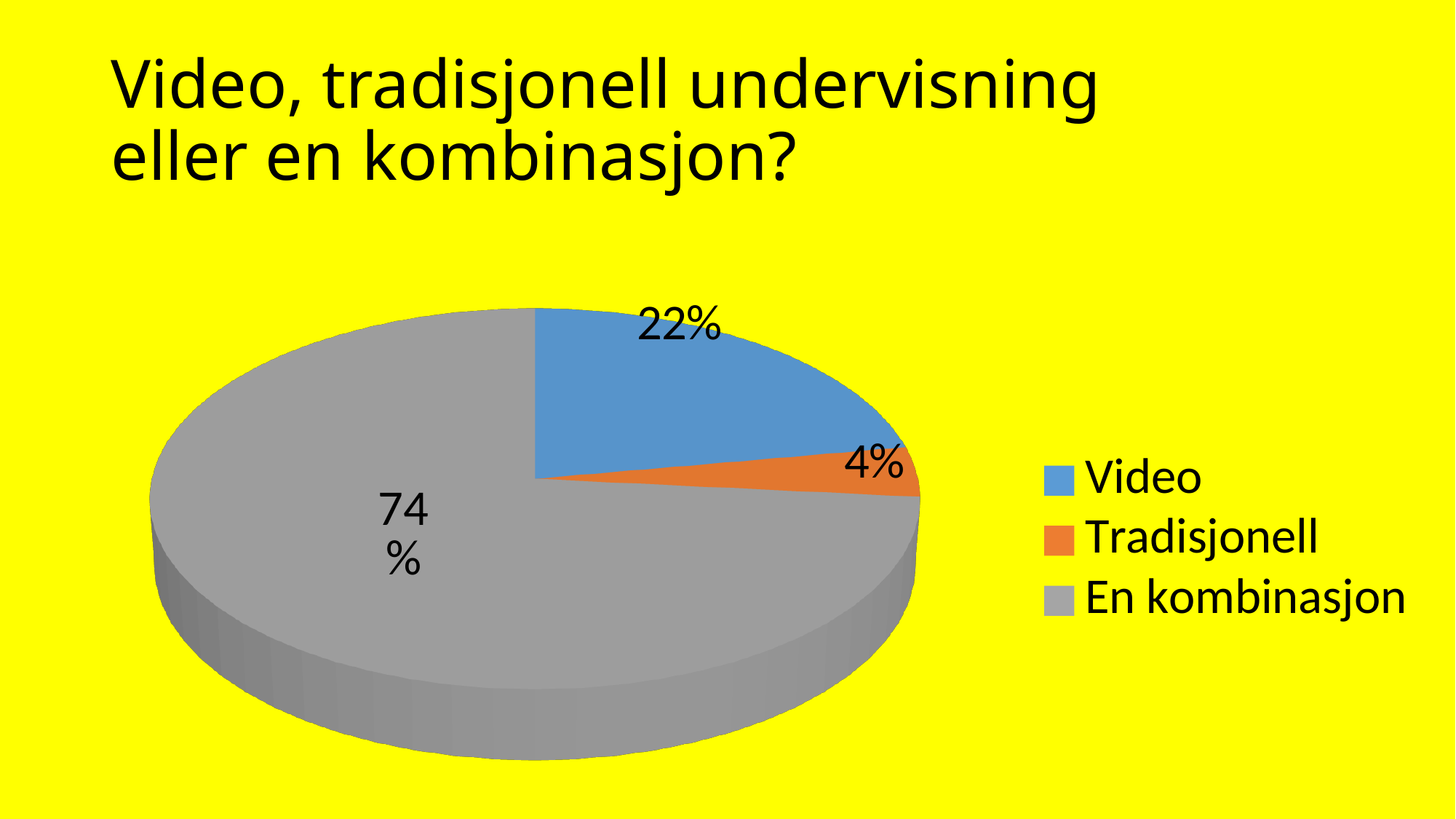
What is the title of the slide containing the chart? Video, tradisjonell undervisning eller en kombinasjon? What kind of chart is shown on the slide? pie chart What colour is the slice for Tradisjonell? orange How many categories does the pie chart have? 3 What share of the pie does Video have? 22% What is the difference in percentage points between Video and Tradisjonell? 18 What is the difference in percentage points between En kombinasjon and Video? 52 Which category has the largest slice of the pie? En kombinasjon Which category has the smallest slice of the pie? Tradisjonell Which is larger, the slice for Video or the slice for Tradisjonell? Video What share of the pie does En kombinasjon have? 74% What share of the pie does Tradisjonell have? 4%